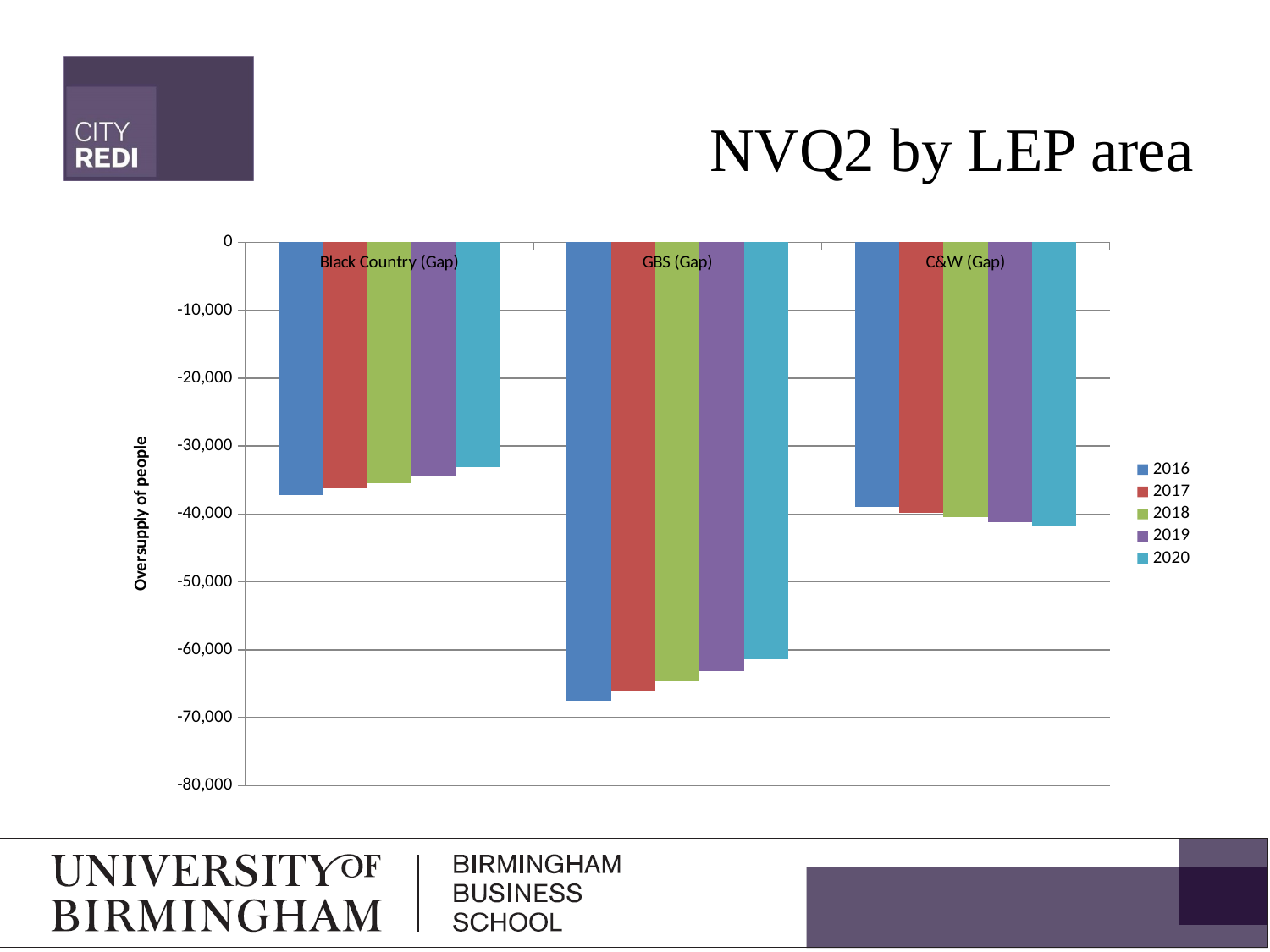
How many series does the legend list? 5 Which LEP area has the lowest (most negative) values across all years? GBS (Gap) Is the value for 2020 in C&W (Gap) greater or less than -40,000? less What kind of chart is shown on the slide? bar chart Is the value for 2016 in GBS (Gap) greater or less than -60,000? less How many LEP area categories are shown on the x axis? 3 Is the value for 2020 in Black Country (Gap) greater or less than -40,000? greater What is the title of the chart? NVQ2 by LEP area What is the label on the vertical axis? Oversupply of people Which is lower, the 2016 value for GBS (Gap) or the 2016 value for Black Country (Gap)? GBS (Gap) Which LEP area has the highest values (closest to zero) across all years? Black Country (Gap) Do the values for C&W (Gap) rise or fall from 2016 to 2020? fall